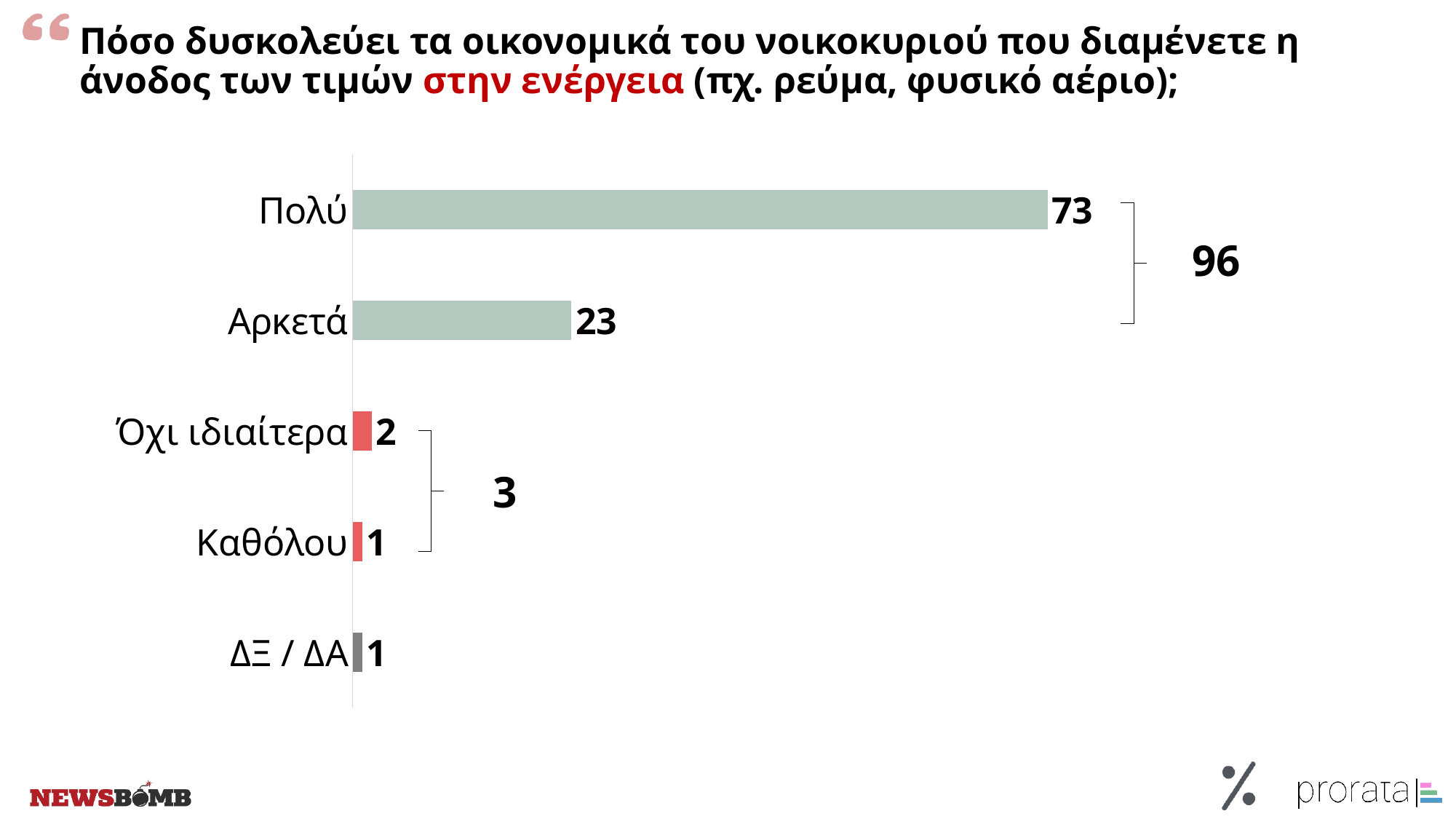
What is the value for Αρκετά? 23 What colour are the bars for Όχι ιδιαίτερα and Καθόλου? Red Which category has the highest value? Πολύ What is the difference between the values for Πολύ and Αρκετά? 50 Which is larger, the value for Αρκετά or the value for Όχι ιδιαίτερα? Αρκετά What is the value for Πολύ? 73 How many categories are shown in the chart? 5 What is the value for Καθόλου? 1 What kind of chart is shown on the slide? Bar chart What is the value for Όχι ιδιαίτερα? 2 What combined value is shown by the bracket grouping Πολύ and Αρκετά? 96 What combined value is shown by the bracket grouping Όχι ιδιαίτερα and Καθόλου? 3